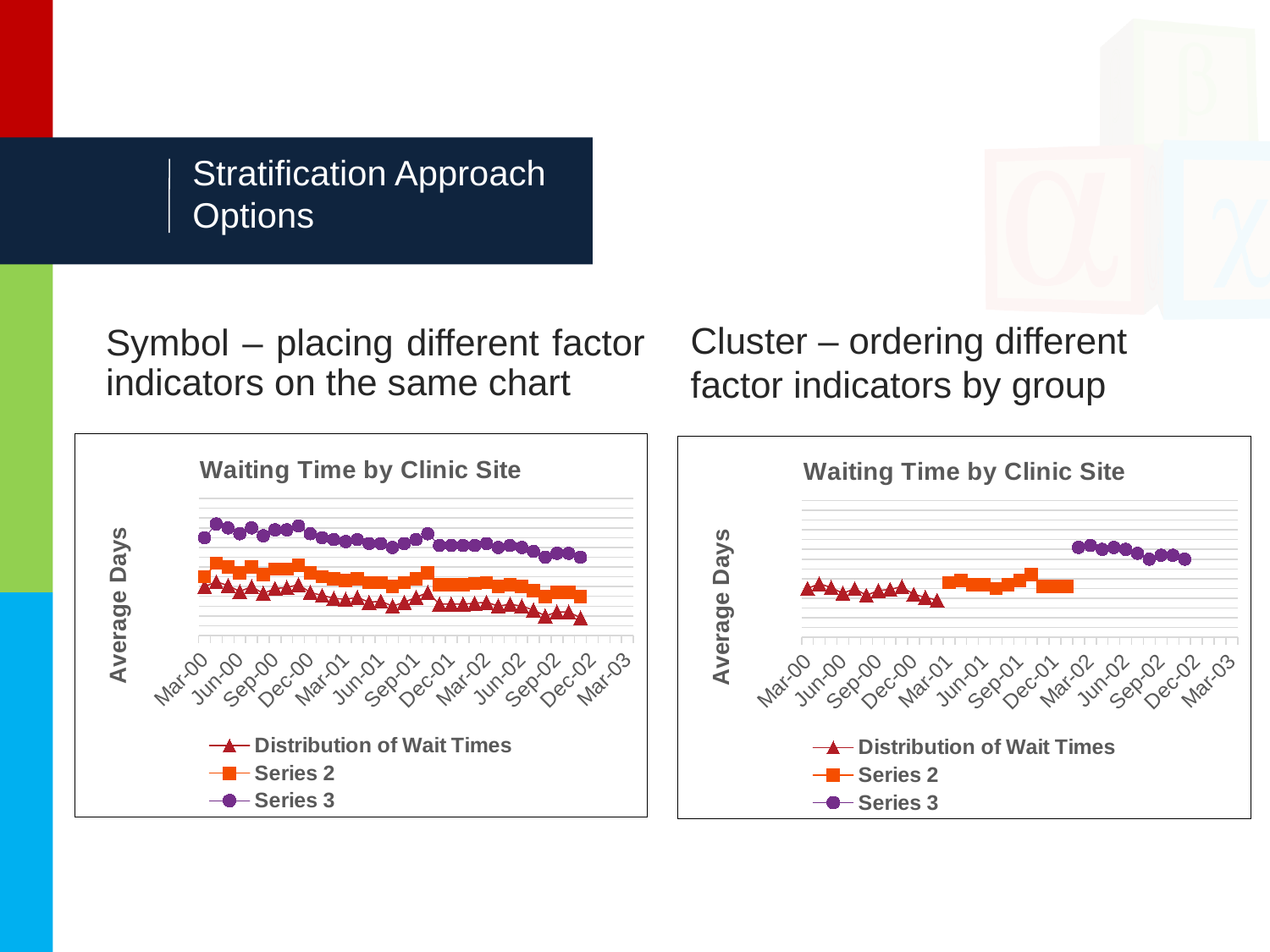
In the left chart, which series has the lowest values throughout? Distribution of Wait Times In the right chart, which series is plotted in the earliest time period (starting at Mar-00)? Distribution of Wait Times What is the y-axis label of the left chart? Average Days In the left chart, do the values of Distribution of Wait Times generally rise or fall from Mar-00 to Dec-02? Fall What type of chart is the left chart, 'Waiting Time by Clinic Site'? Line chart In the left chart, which series has the highest values throughout? Series 3 What is the last x-axis label on the left chart? Mar-03 How many x-axis labels are shown on the right chart? 13 In the right chart, which series is plotted higher, Series 3 or Series 2? Series 3 How many series does the legend of the right chart list? 3 In the right chart, which series is plotted higher, Series 2 or Distribution of Wait Times? Series 2 In the left chart, do the values of Series 3 generally rise or fall from Mar-00 to Dec-02? Fall